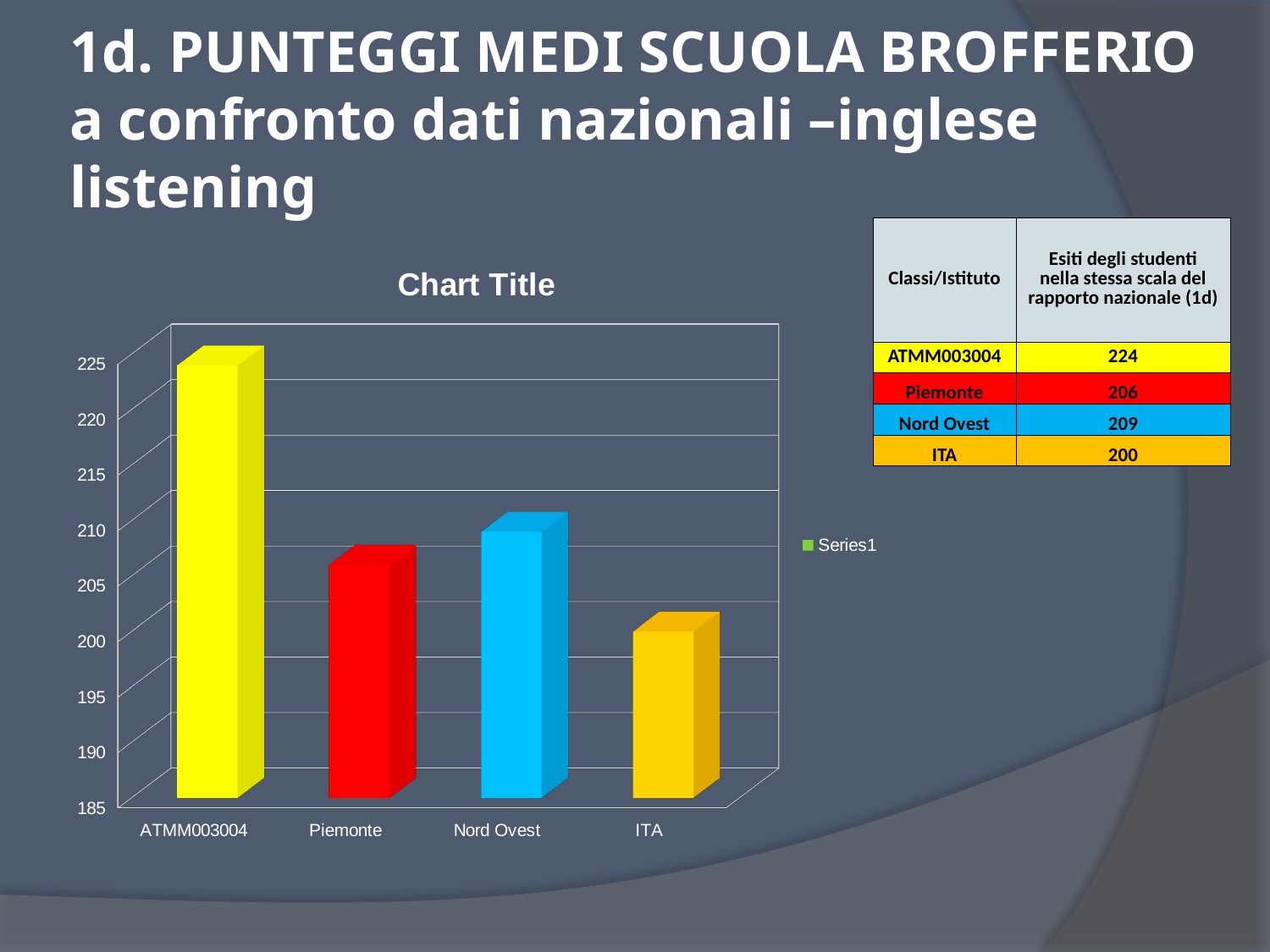
According to the table, what is the value for ATMM003004? 224 What type of chart is shown on the slide? bar chart What is the title shown above the chart? Chart Title According to the table, what is the value for Nord Ovest? 209 Which category has the lowest bar in the chart? ITA What is the difference between the values for ATMM003004 and ITA shown in the table? 24 Which category has the highest bar in the chart? ATMM003004 Which is larger, the value for Nord Ovest or the value for Piemonte? Nord Ovest How many categories are plotted on the x axis of the chart? 4 How many series does the chart legend list? 1 Is the value for ATMM003004 greater or less than 220? greater According to the table, what is the value for Piemonte? 206